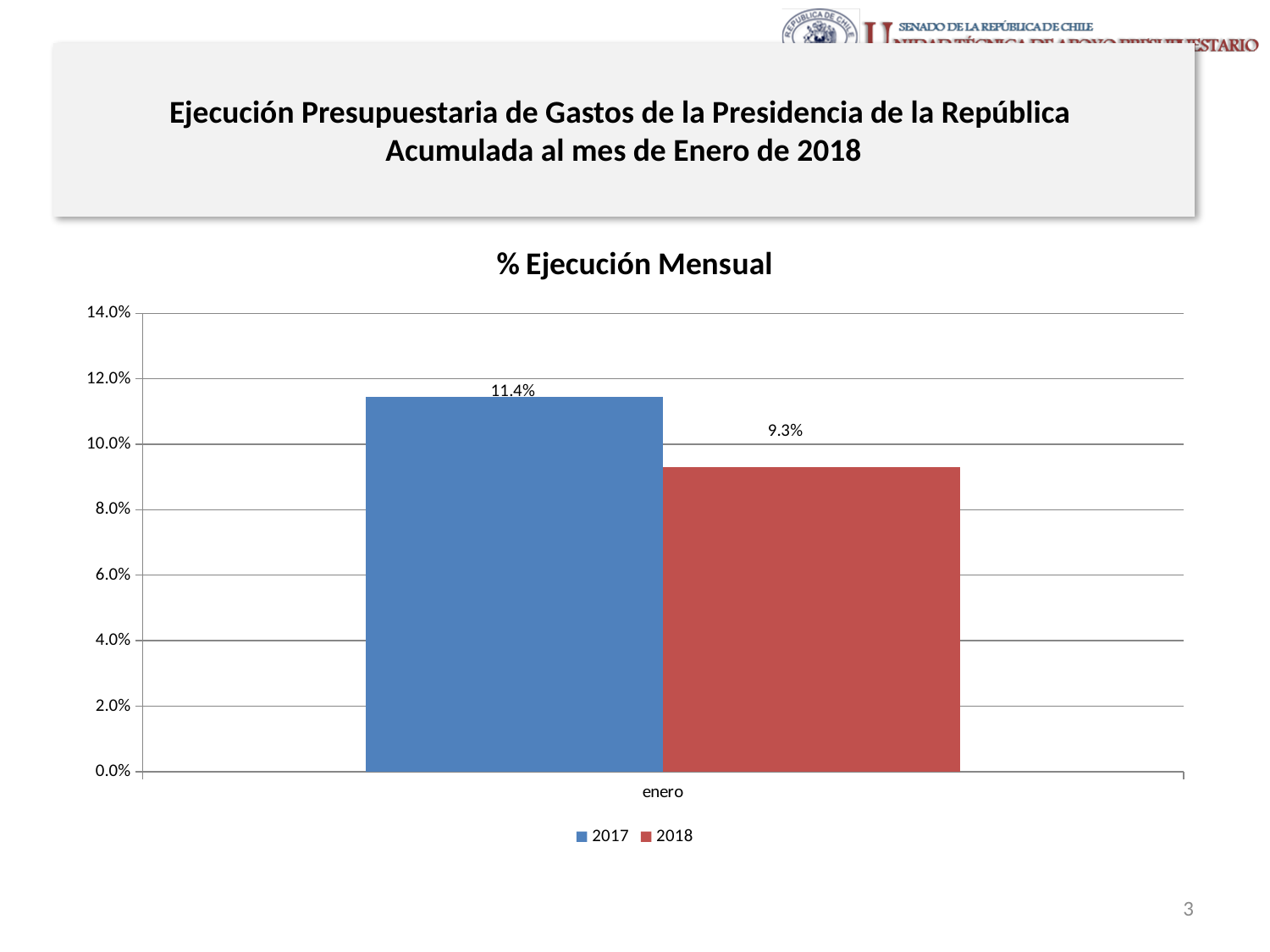
How many series does the legend list? 2 What is the highest value shown on the y axis? 14.0% Is the value for 2017 in enero greater or less than 10.0%? greater What is the difference between the 2017 and 2018 values for enero? 2.1% What kind of chart is shown? bar chart What is the value for 2018 in enero? 9.3% How many categories are shown on the x axis? 1 What is the value for 2017 in enero? 11.4% Which series is shown in red? 2018 What is the title of the chart? % Ejecución Mensual Which series has the higher value for enero, 2017 or 2018? 2017 Is the value for 2018 in enero greater or less than 10.0%? less